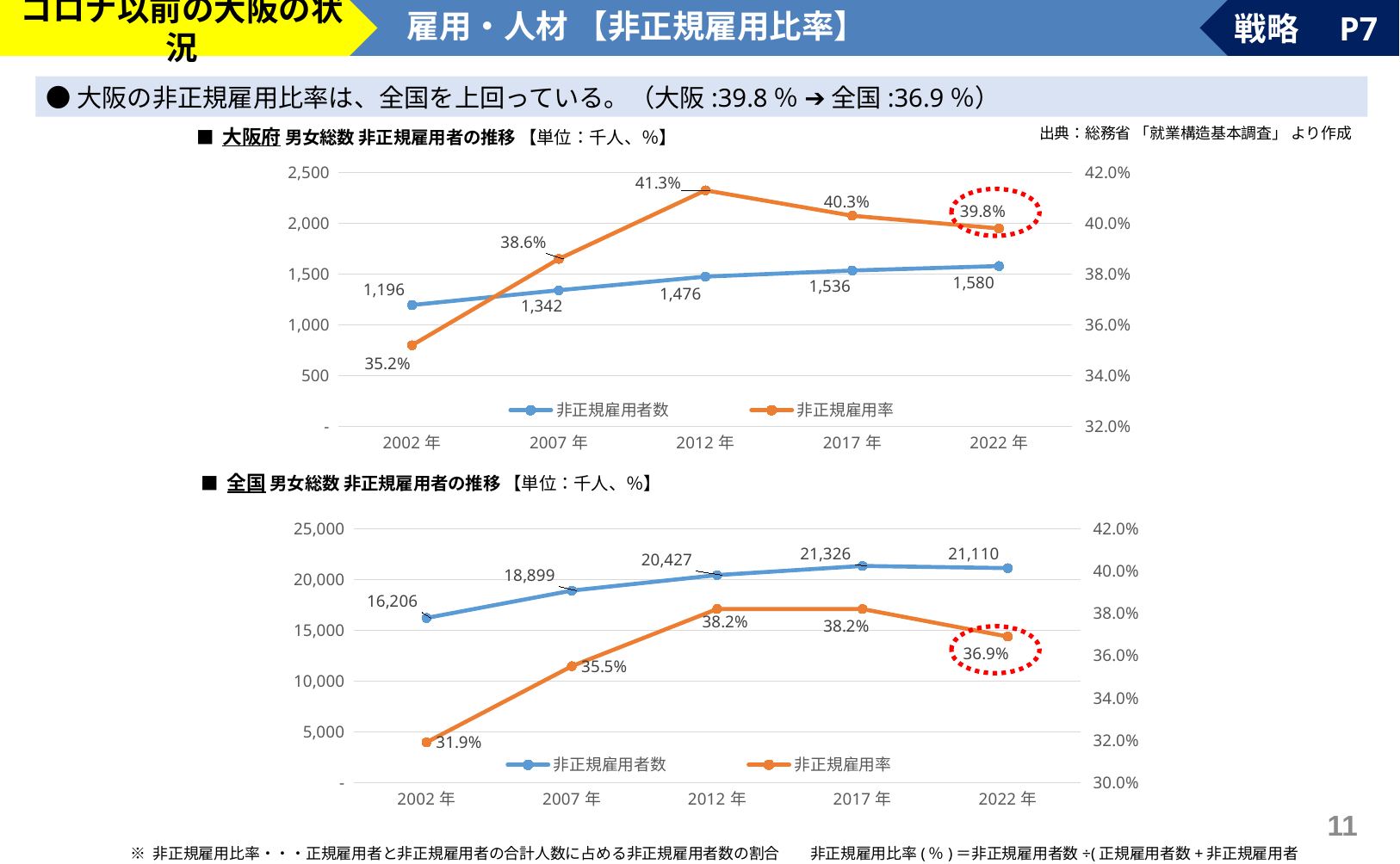
In the 大阪府 chart (top), in which year is the 非正規雇用率 highest? 2012年 In the 大阪府 chart (top), what is the difference in 非正規雇用者数 between 2022年 and 2002年? 384 In the 全国 chart (bottom), which is larger, the 非正規雇用率 in 2022年 or in 2017年? 2017年 In the 全国 chart (bottom), what is the value of 非正規雇用者数 in 2017年? 21,326 In the 大阪府 chart (top), what is the value of 非正規雇用者数 in 2022年? 1,580 What kind of chart is the 大阪府 chart (top)? line chart In the 全国 chart (bottom), what is the 非正規雇用率 in 2002年? 31.9% In the 全国 chart (bottom), in which year is the 非正規雇用者数 highest? 2017年 In the 大阪府 chart (top), what is the 非正規雇用率 in 2012年? 41.3% How many series does the legend of the 全国 chart (bottom) list? 2 In the 大阪府 chart (top), in which year is the 非正規雇用率 lowest? 2002年 In the 大阪府 chart (top), does the 非正規雇用者数 rise or fall from 2002年 to 2022年? rise